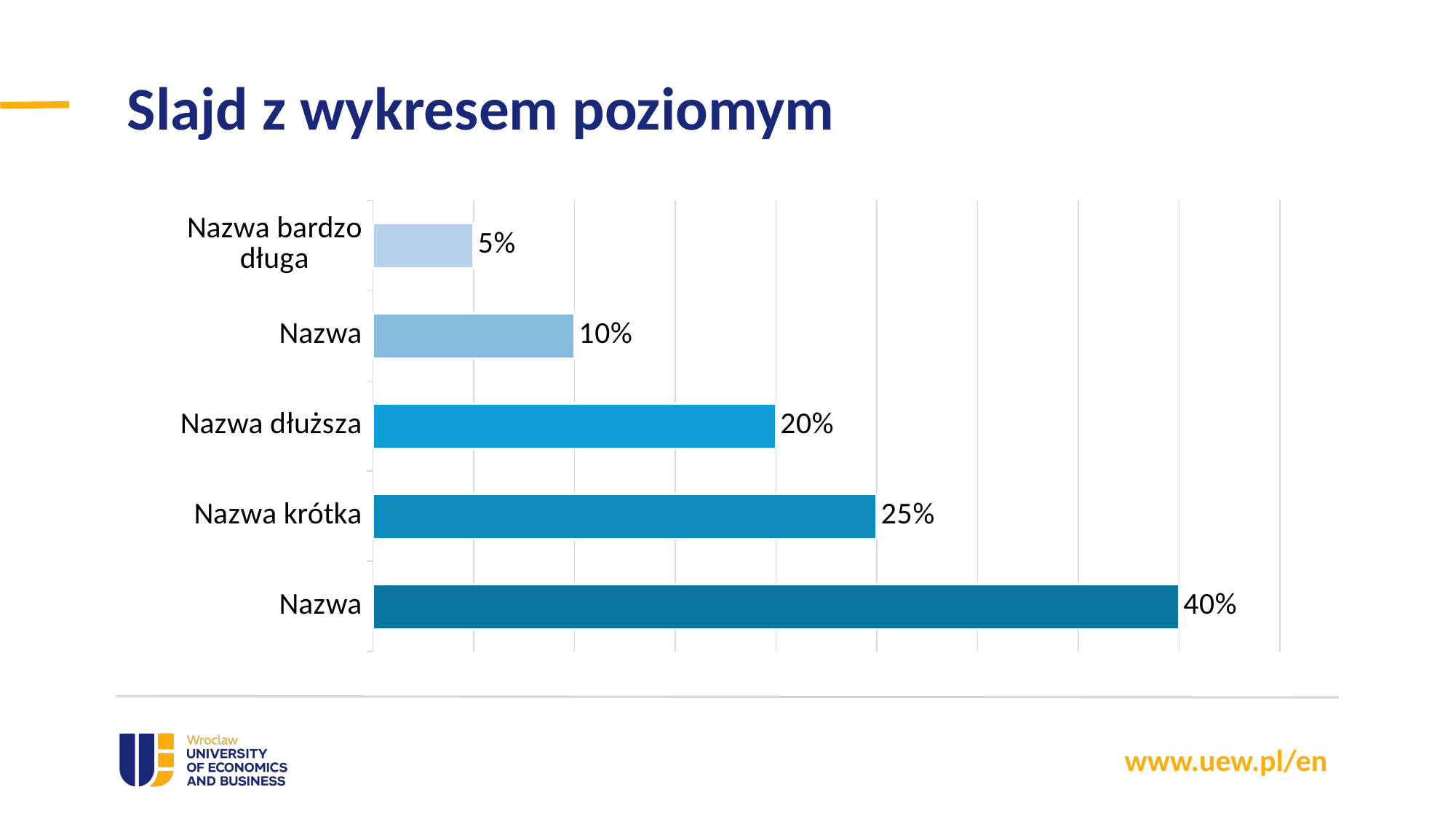
What kind of chart is shown on the slide? bar chart Which is larger, the value for "Nazwa dłuższa" or the value for "Nazwa bardzo długa"? Nazwa dłuższa Which category has the lowest value? Nazwa bardzo długa What is the value of the second bar from the top, labelled "Nazwa"? 10% What is the title of the slide? Slajd z wykresem poziomym What is the value for "Nazwa bardzo długa"? 5% What is the value of the bottom bar, labelled "Nazwa"? 40% What is the highest value shown in the chart? 40% What is the value for "Nazwa dłuższa"? 20% What is the difference between the values for "Nazwa krótka" and "Nazwa dłuższa"? 5% How many bars are in the chart? 5 What is the value for "Nazwa krótka"? 25%